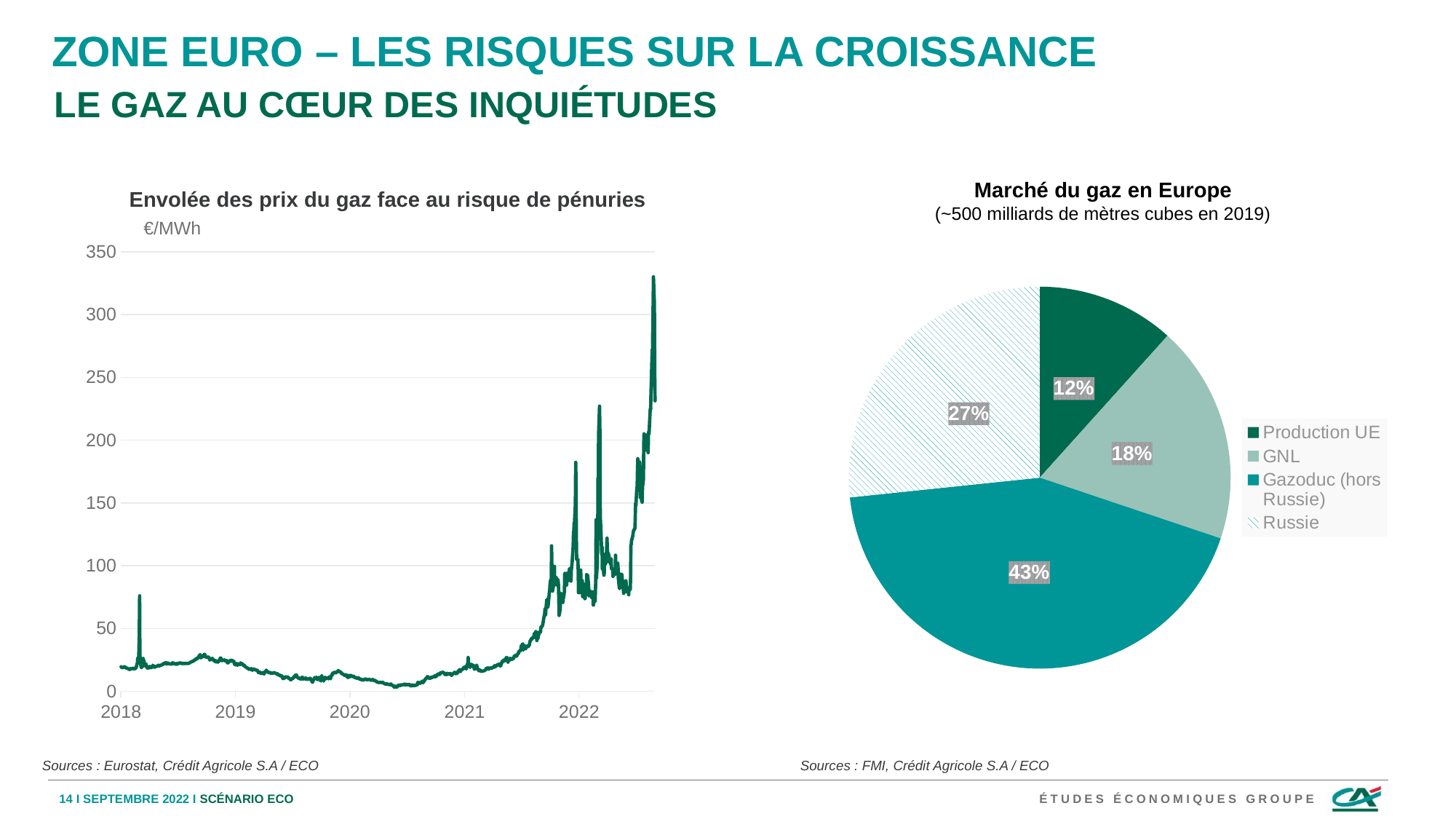
How many categories does the legend of the 'Marché du gaz en Europe' pie chart list? 4 In the 'Envolée des prix du gaz face au risque de pénuries' chart, is the value at the start of 2018 greater or less than 50? less What unit is shown on the y axis of the 'Envolée des prix du gaz face au risque de pénuries' chart? €/MWh What kind of chart is 'Envolée des prix du gaz face au risque de pénuries'? Line chart In the 'Marché du gaz en Europe' pie chart, which category has the largest share? Gazoduc (hors Russie) In the 'Marché du gaz en Europe' pie chart, which category has the smallest share? Production UE In the 'Marché du gaz en Europe' pie chart, what share does Gazoduc (hors Russie) represent? 43% In the 'Marché du gaz en Europe' pie chart, what share does Production UE represent? 12% In the 'Marché du gaz en Europe' pie chart, what is the difference in percentage points between the Russie share and the GNL share? 9 percentage points In the 'Marché du gaz en Europe' pie chart, what share does GNL represent? 18% In the 'Envolée des prix du gaz face au risque de pénuries' chart, is the peak value reached in 2022 greater or less than 300? greater